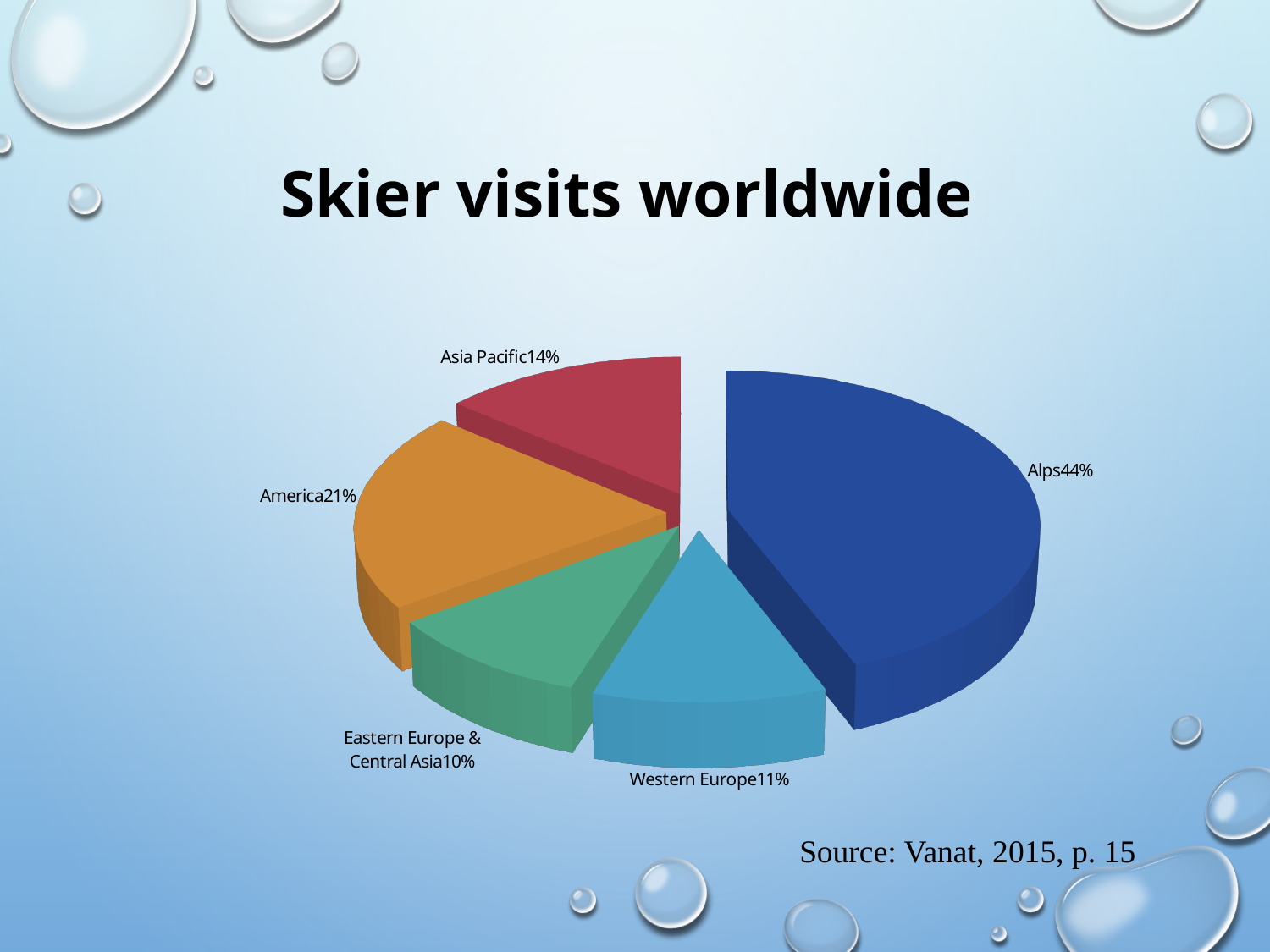
What percentage is shown for Western Europe? 11% What share of skier visits worldwide does the Alps slice represent? 44% Which region has the smallest share of skier visits? Eastern Europe & Central Asia What percentage is shown for Eastern Europe & Central Asia? 10% What is the difference in percentage points between the Alps and America? 23 What percentage is shown for Asia Pacific? 14% What type of chart is shown on the slide? Pie chart How many regions are shown in the pie chart? 5 What percentage is shown for America? 21% Which has a larger share, Asia Pacific or Western Europe? Asia Pacific What is the title of the chart? Skier visits worldwide Which region has the largest share of skier visits? Alps